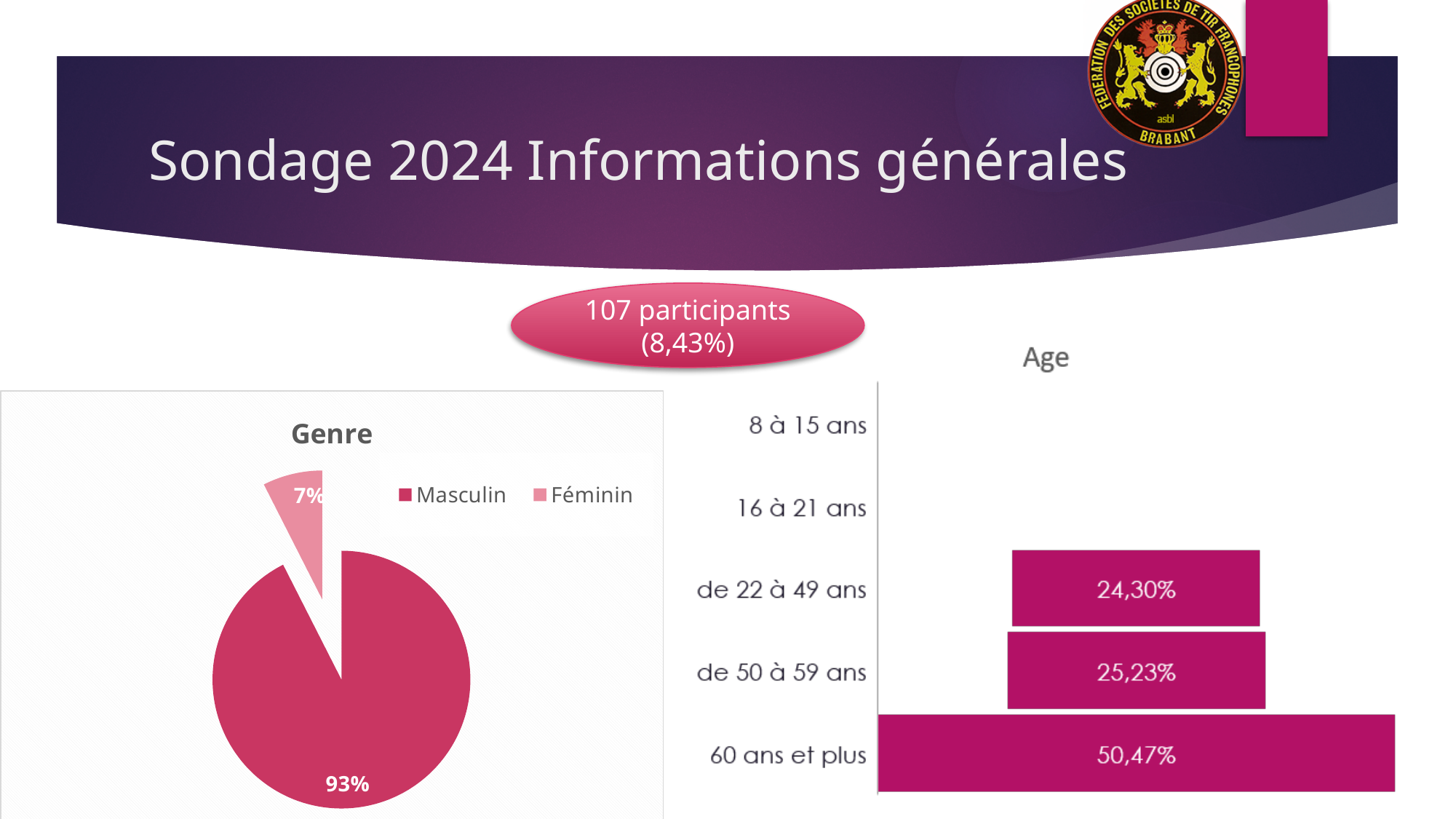
What kind of chart is the Age chart? bar chart In the Genre pie chart, what share is Masculin? 93% In the Age chart, what is the value for de 22 à 49 ans? 24,30% How many entries does the legend of the Genre chart list? 2 How many age categories are listed on the Age chart? 5 What kind of chart is the Genre chart? pie chart In the Age chart, which age category has the highest value? 60 ans et plus In the Genre pie chart, what share is Féminin? 7% In the Age chart, what is the value for de 50 à 59 ans? 25,23% In the Age chart, what is the value for 60 ans et plus? 50,47% In the Genre chart, which category has the larger share, Masculin or Féminin? Masculin In the Age chart, what is the difference between 60 ans et plus and de 50 à 59 ans? 25,24%